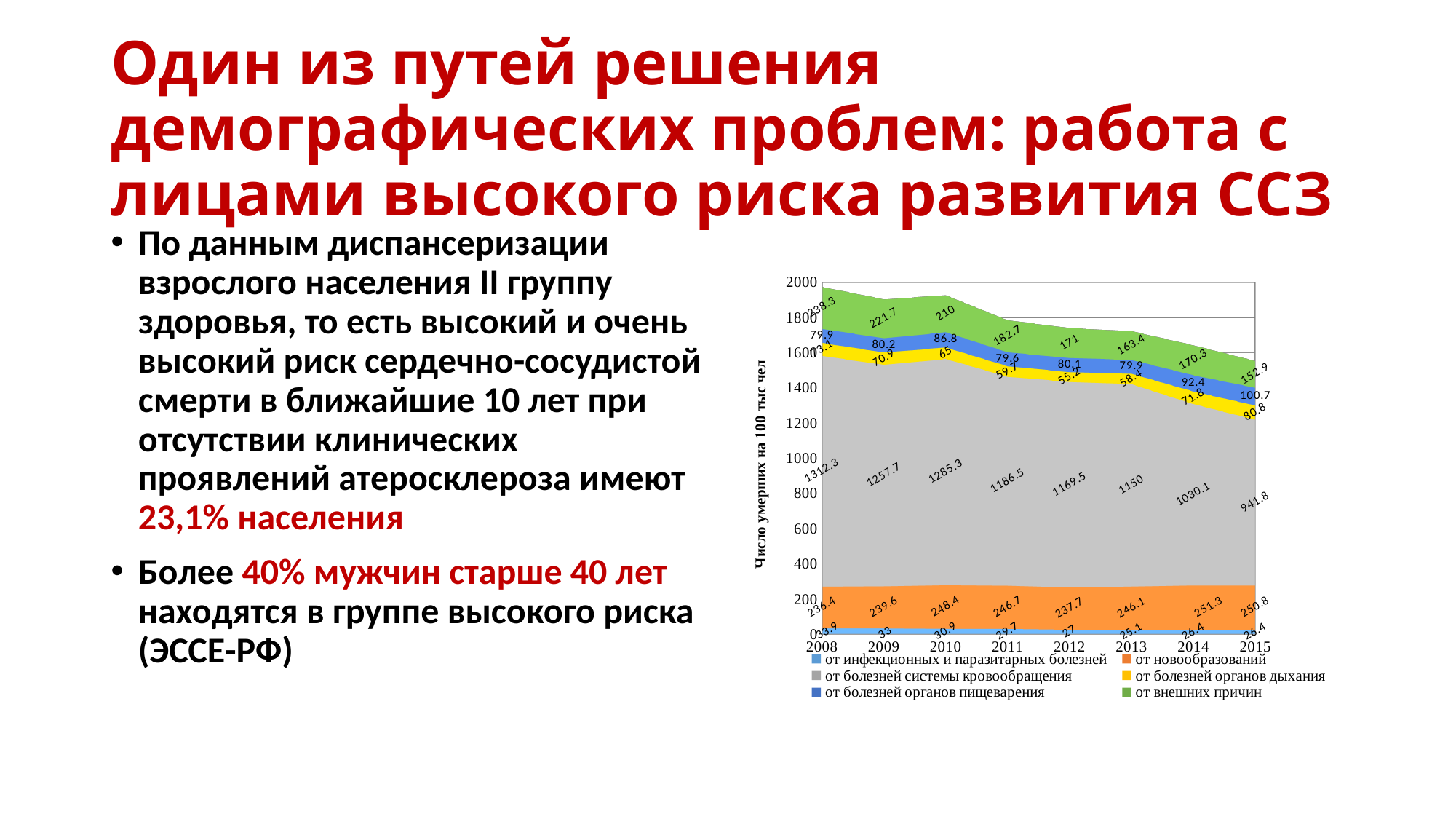
What is the value for 'от внешних причин' in 2008? 238.3 What is the value for 'от болезней органов пищеварения' in 2015? 100.7 How many series does the chart's legend list? 6 In which year is the value for 'от внешних причин' lowest? 2015 In which year is the value for 'от болезней системы кровообращения' highest? 2008 Which year has the larger value for 'от новообразований': 2008 or 2014? 2014 What kind of chart is shown on the slide? Stacked area chart What is the difference between the 2008 and 2015 values for 'от внешних причин'? 85.4 Does the value for 'от болезней системы кровообращения' generally rise or fall from 2008 to 2015? Fall How many years are plotted on the x axis of the chart? 8 What is the difference between the 2008 and 2015 values for 'от болезней системы кровообращения'? 370.5 What is the value for 'от болезней системы кровообращения' in 2015? 941.8